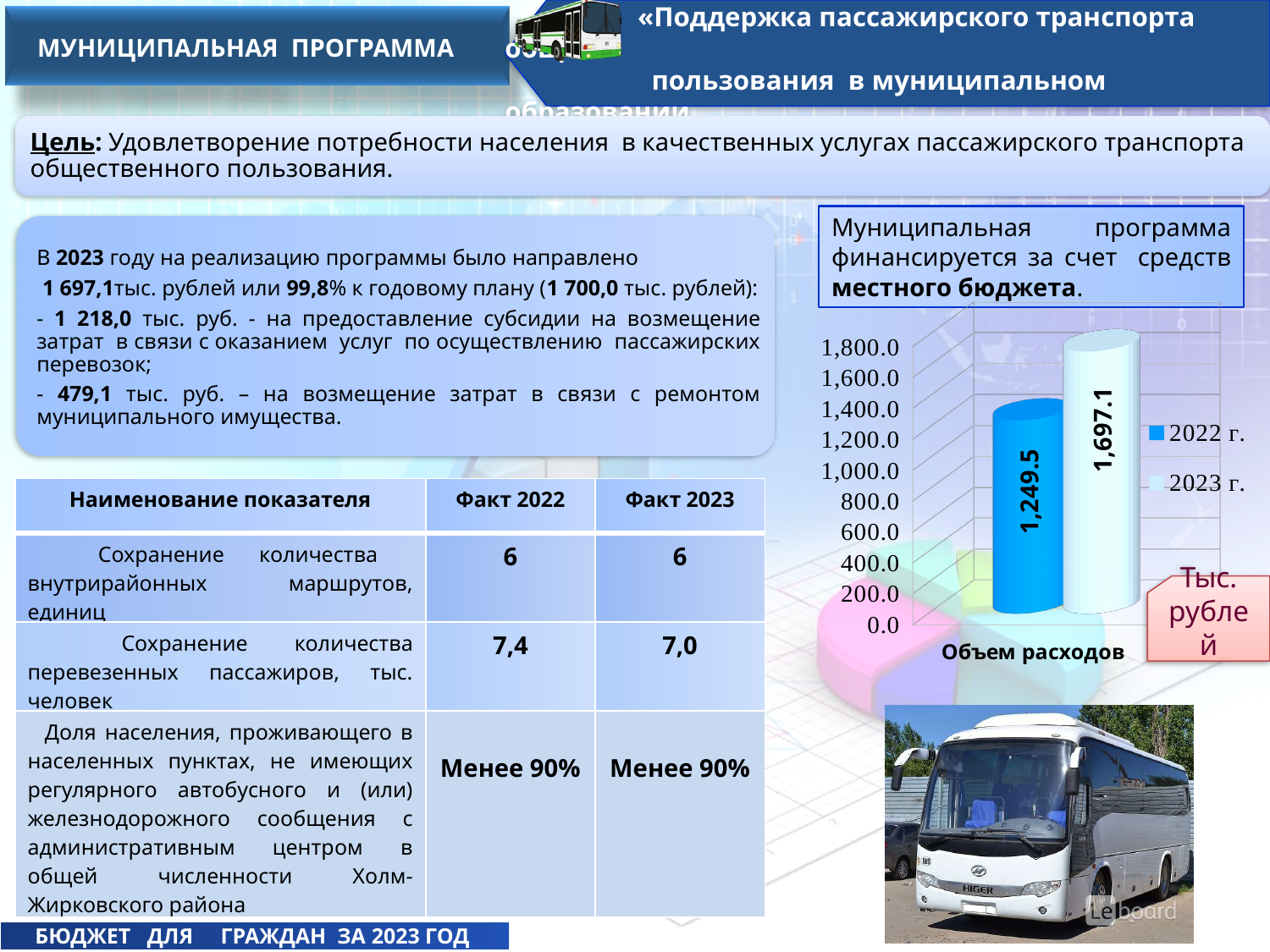
How many categories are shown on the x axis of the chart? 1 Which series has the higher value in the chart, 2022 г. or 2023 г.? 2023 г. Which series has the lowest value in the chart? 2022 г. What is the highest tick value shown on the y axis of the chart? 1,800.0 Is the value for 2022 г. in the chart greater or less than 1,400.0? less What is the value for the 2023 г. series in the chart? 1,697.1 How many series does the chart legend list? 2 What kind of chart is shown on the slide? Bar chart What is the category label on the x axis of the chart? Объем расходов What is the value for the 2022 г. series in the chart? 1,249.5 Is the value for 2023 г. in the chart greater or less than 1,600.0? greater What is the difference between the 2023 г. and 2022 г. values in the chart? 447.6